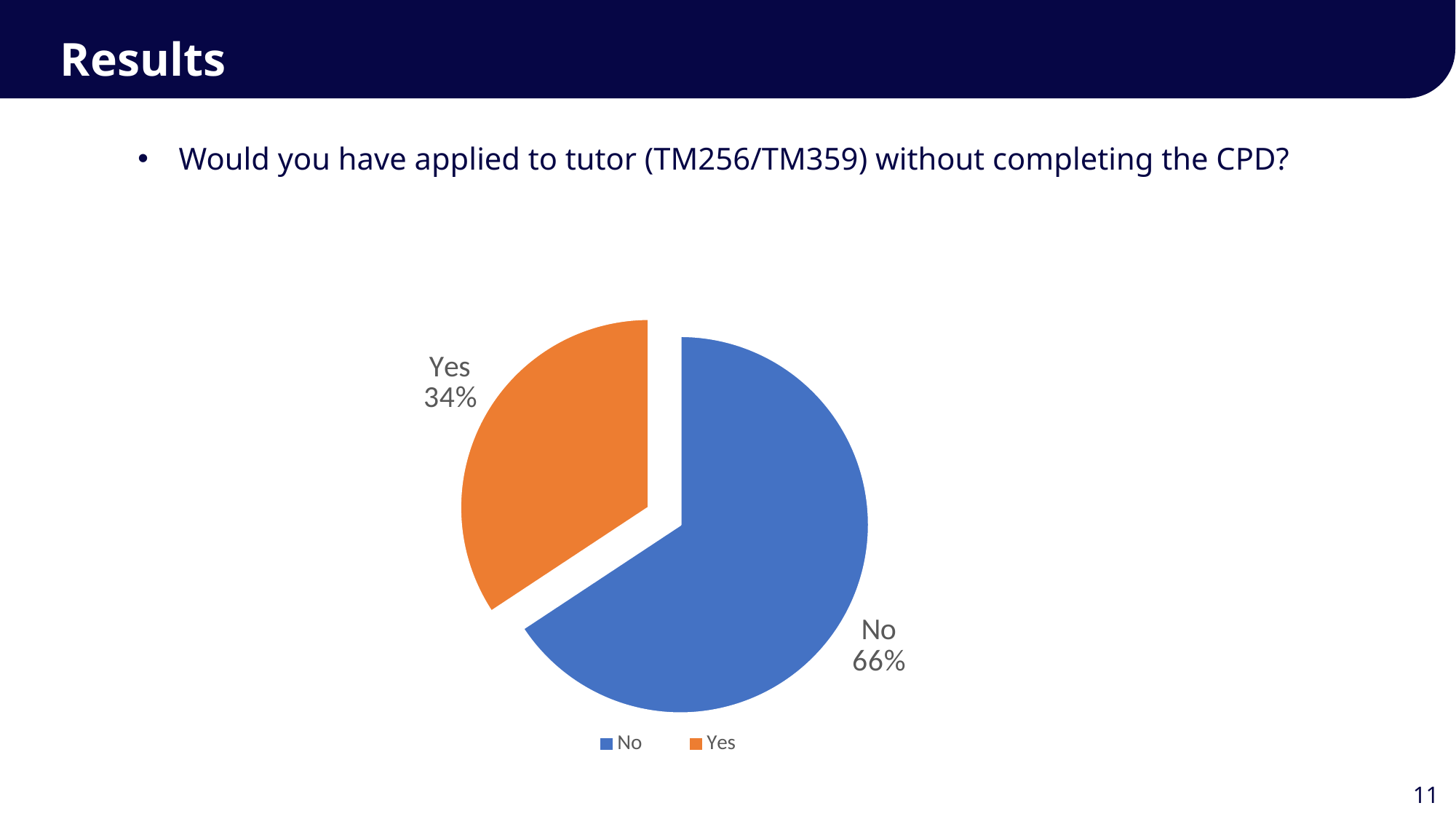
What colour is the No slice? blue What kind of chart is shown on the slide? pie chart How many entries does the legend list? 2 What colour is the Yes slice? orange What share of the pie does the Yes slice represent? 34% Which response has the smallest share of the pie? Yes Which slice is larger, Yes or No? No How many slices does the pie chart have? 2 What percentage of respondents answered No? 66% What percentage of respondents answered Yes? 34% What is the difference in percentage points between the No and Yes slices? 32 Which response has the largest share of the pie? No